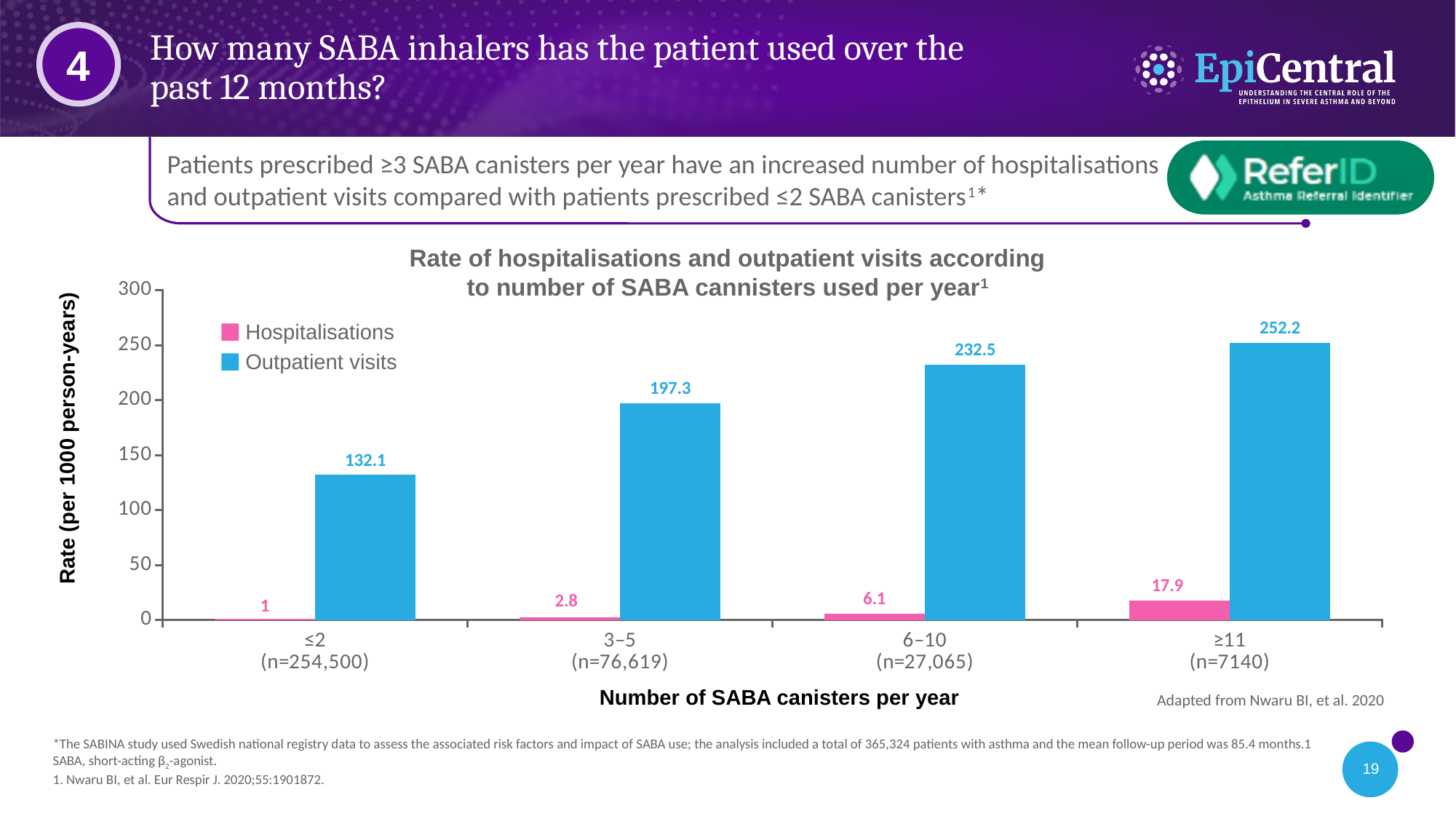
What is the rate of outpatient visits for patients using ≤2 SABA canisters per year? 132.1 Do the outpatient visit rates rise or fall as the number of SABA canisters per year increases? Rise What is the rate of hospitalisations for patients using ≥11 SABA canisters per year? 17.9 What is the difference in outpatient visit rate between the ≥11 group and the ≤2 group? 120.1 Which SABA canister group has the lowest rate of hospitalisations? ≤2 Which SABA canister group has the highest rate of outpatient visits? ≥11 What kind of chart is shown on the slide? Bar chart What is the rate of hospitalisations for the 3–5 canisters per year group? 2.8 Which is larger: the outpatient visit rate for the 3–5 group or for the 6–10 group? 6–10 How many SABA canister categories are shown on the x axis? 4 How many series does the legend list? 2 What is the rate of outpatient visits for the 6–10 canisters per year group? 232.5